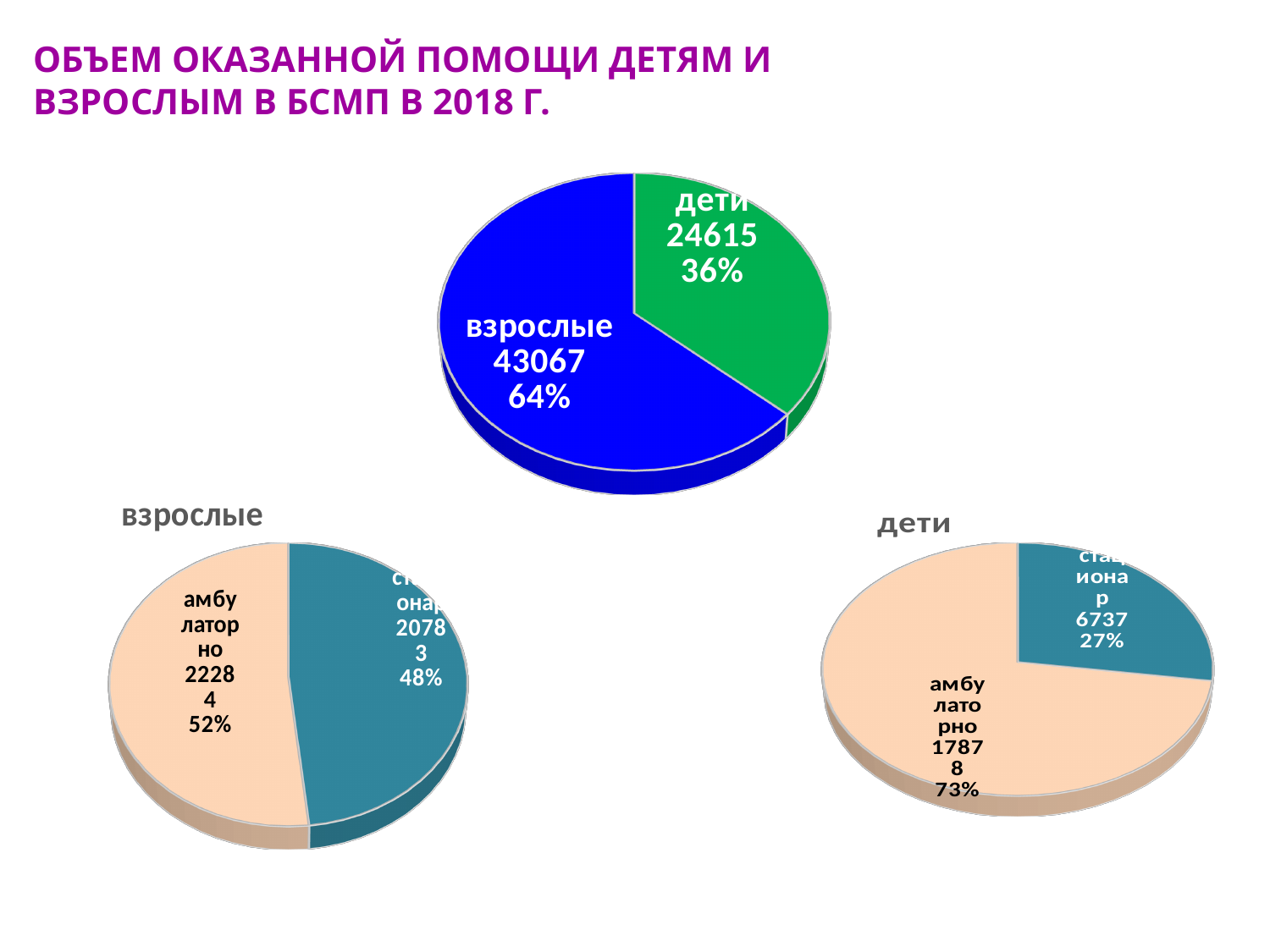
How many pie charts are on the slide? 3 What kind of chart is the top chart on the slide? pie chart In the top pie chart, which category has the larger slice? взрослые In the bottom-left pie chart titled взрослые, what share of the pie is стационар? 48% In the bottom-right pie chart titled дети, what share of the pie is амбулаторно? 73% In the top pie chart, what share of the pie is дети? 36% Which is larger: амбулаторно in the bottom-left chart (взрослые) or амбулаторно in the bottom-right chart (дети)? амбулаторно in the взрослые chart In the top pie chart, what value is shown for взрослые? 43067 In the bottom-left pie chart titled взрослые, what value is shown for амбулаторно? 22284 In the top pie chart, what is the difference between the values for взрослые and дети? 18452 In the bottom-right pie chart titled дети, what value is shown for стационар? 6737 In the bottom-right pie chart titled дети, which category has the smaller slice? стационар